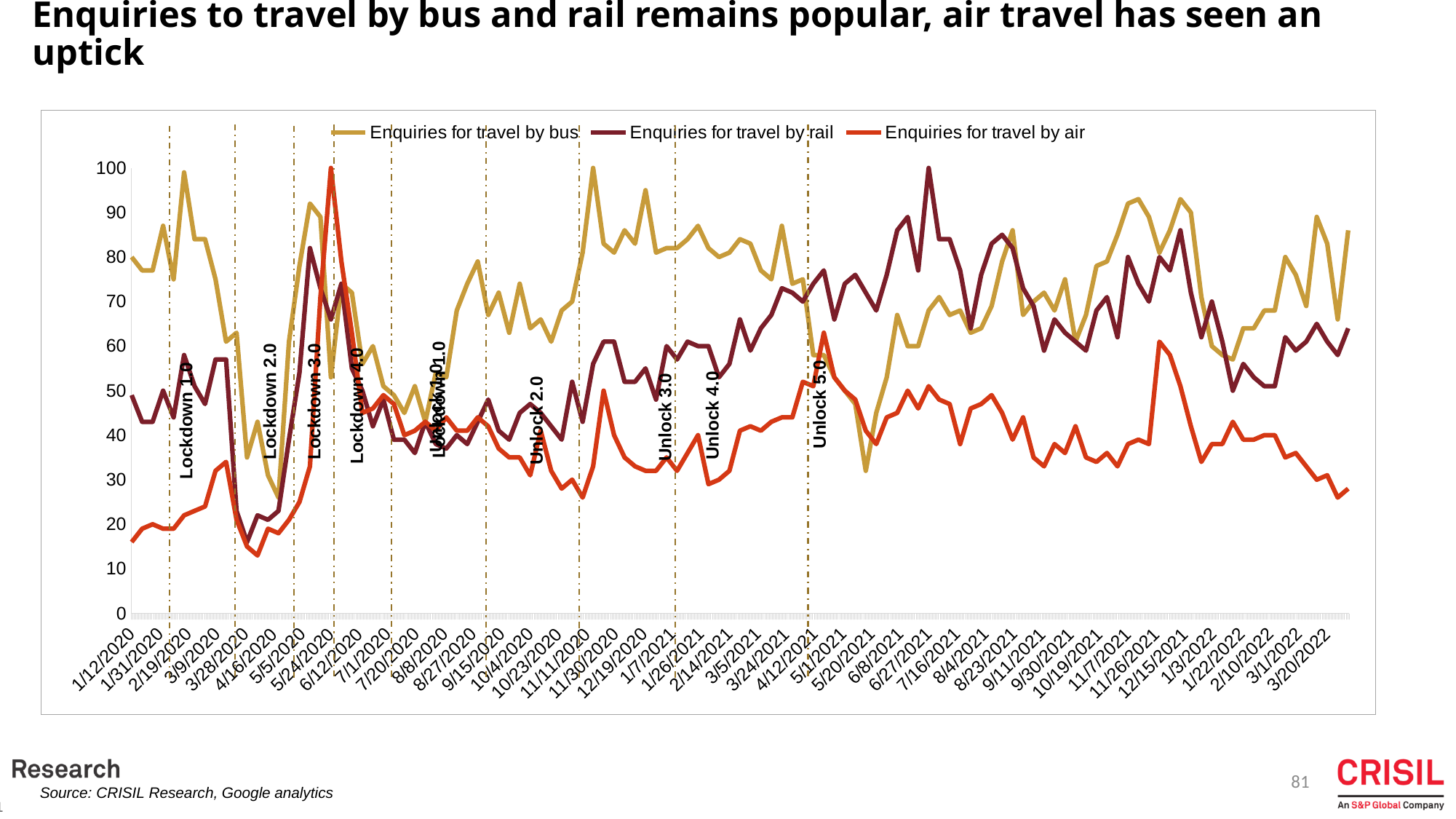
At 3/20/2022, which series has the lowest value? Enquiries for travel by air Is the value for Enquiries for travel by rail at 7/16/2021 greater or less than 90? less Is the value for Enquiries for travel by bus at 3/20/2022 greater or less than 80? greater Does the Enquiries for travel by air series rise or fall between 11/26/2021 and 3/20/2022? fall What is the source cited for the chart? CRISIL Research, Google analytics How many series does the legend list? 3 What kind of chart is shown on the slide? Line chart At 7/16/2021, which is larger: Enquiries for travel by rail or Enquiries for travel by bus? Enquiries for travel by rail Is the value for Enquiries for travel by air at 1/12/2020 greater or less than 20? less Which series is shown in red? Enquiries for travel by air